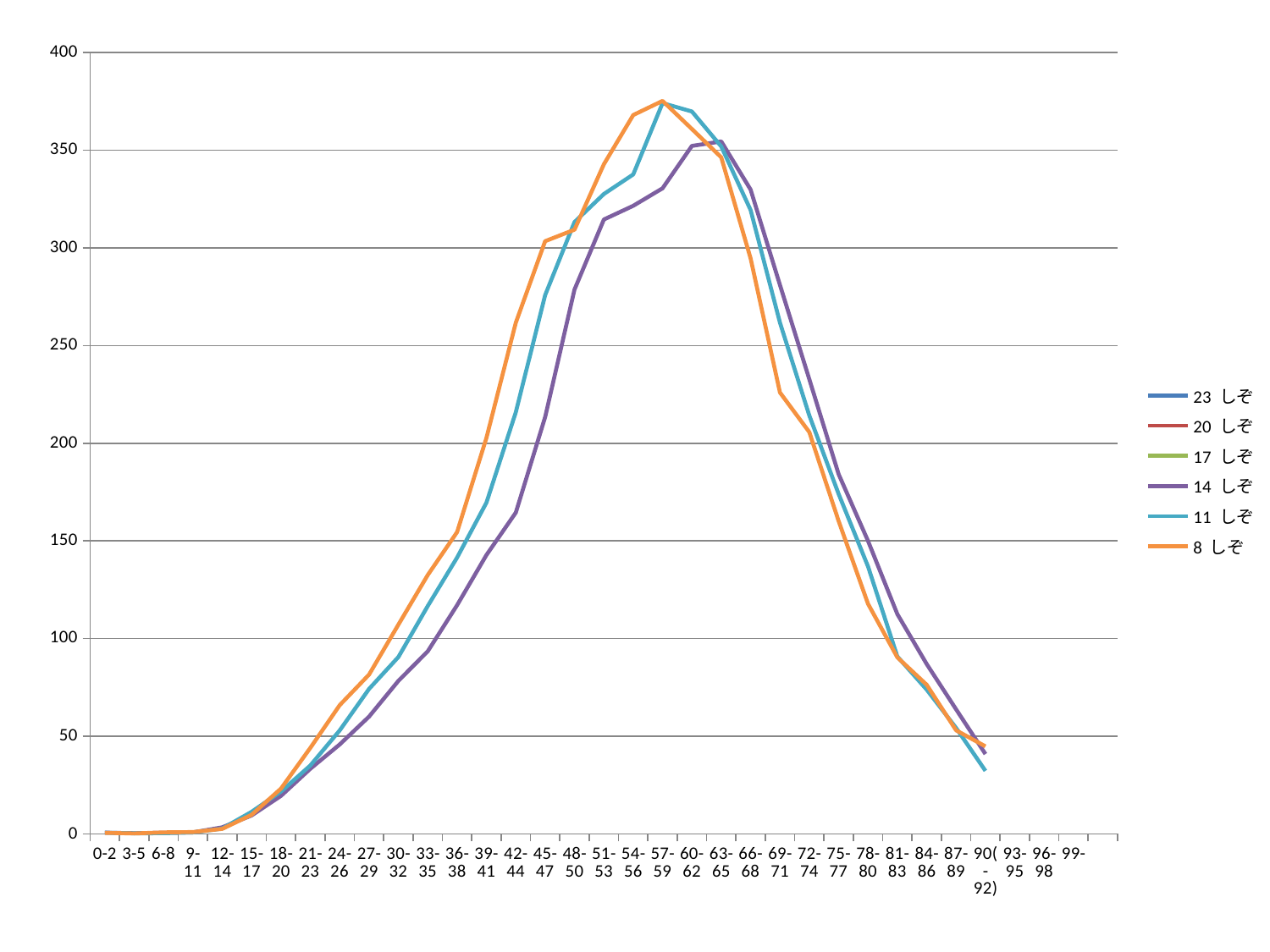
Do the values for 8 しぞ rise or fall from 57-59 to 90(-92)? fall How many categories are shown on the x axis? 34 Is the value for 11 しぞ at 90(-92) greater or less than 50? less Is the value for 11 しぞ at 54-56 greater or less than 300? greater At 45-47, which series has the larger value, 8 しぞ or 14 しぞ? 8 しぞ At which category does the 8 しぞ series reach its highest value? 57-59 What kind of chart is shown on the slide? line chart Is the value for 8 しぞ at 69-71 greater or less than 250? less How many series does the legend list? 6 At 66-68, which series has the larger value, 14 しぞ or 8 しぞ? 14 しぞ